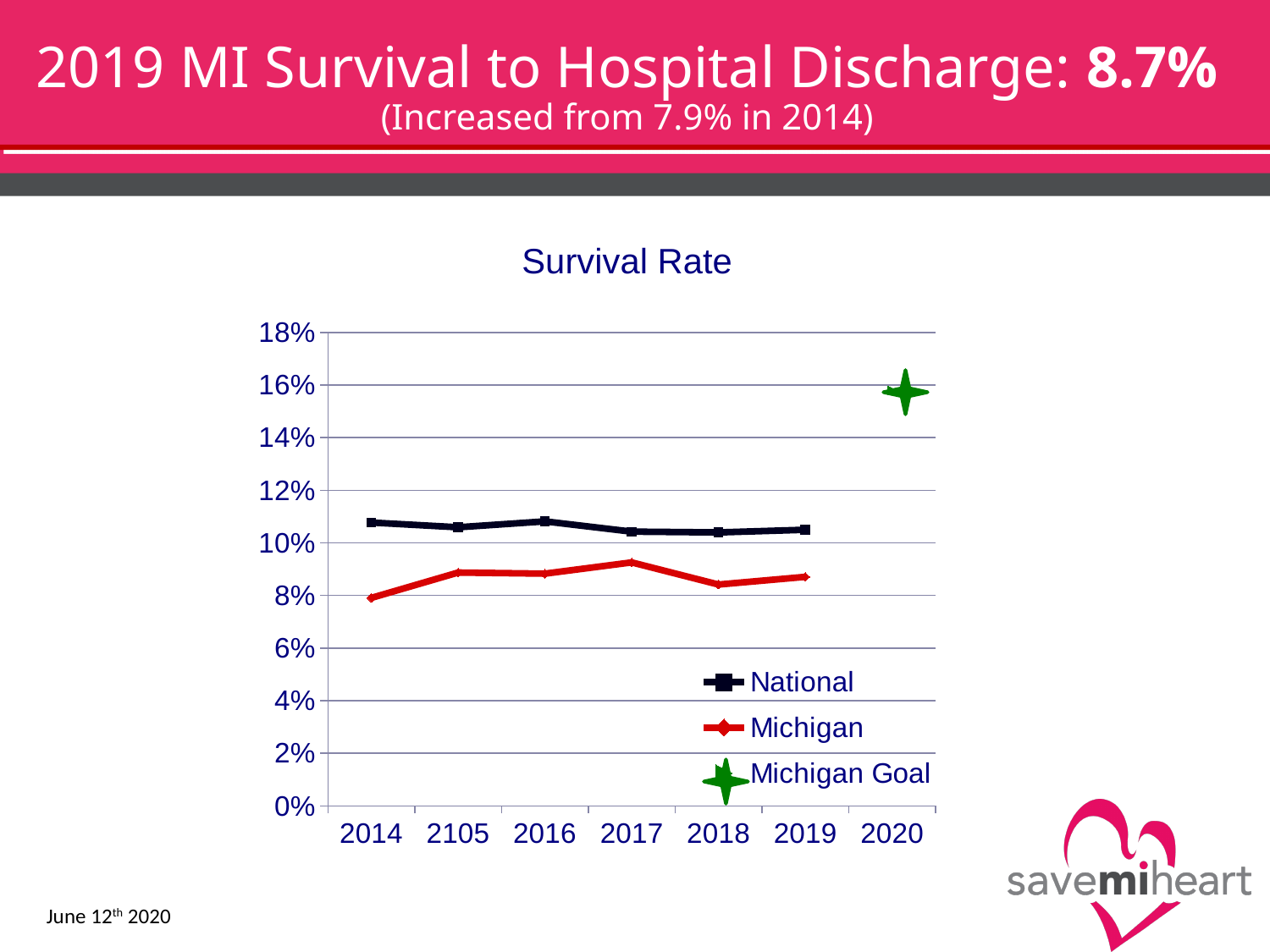
In which year is the Michigan series at its lowest? 2014 What is the title of the chart? Survival Rate What type of chart is shown on the slide? line chart What is the Michigan survival rate for 2019? 8.7% How many year labels are shown on the x axis of the chart? 7 Is the Michigan Goal value for 2020 greater or less than 14%? greater What was the Michigan survival rate in 2014? 7.9% How many series does the chart legend list? 3 In 2016, which series has the higher value, National or Michigan? National By how much did the Michigan survival rate increase from 2014 to 2019? 0.8% Which colour is used for the Michigan series line? red Is the National value for 2014 greater or less than 10%? greater